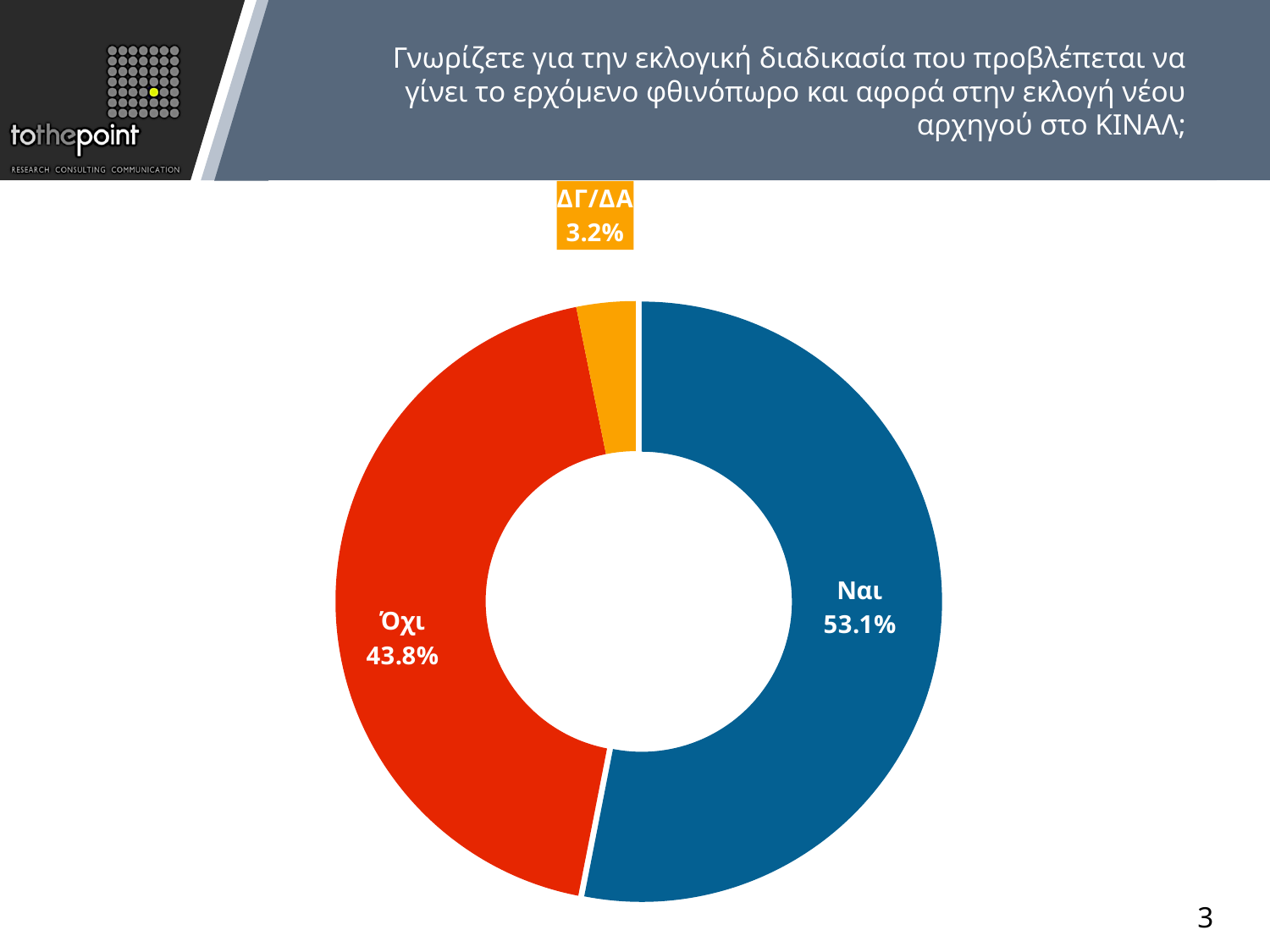
Which is larger, the share for Όχι or the share for ΔΓ/ΔΑ? Όχι Is the share for Όχι greater or less than 50%? less What percentage of respondents answered Ναι? 53.1% What percentage of respondents answered Όχι? 43.8% What kind of chart is shown on the slide? Doughnut (pie) chart Which response has the largest share of the chart? Ναι What is the difference in percentage points between Ναι and Όχι? 9.3 What colour is the ΔΓ/ΔΑ segment of the chart? Orange Which response has the smallest share of the chart? ΔΓ/ΔΑ How many categories are shown in the chart? 3 What colour is the Ναι segment of the chart? Blue What percentage is shown for ΔΓ/ΔΑ? 3.2%